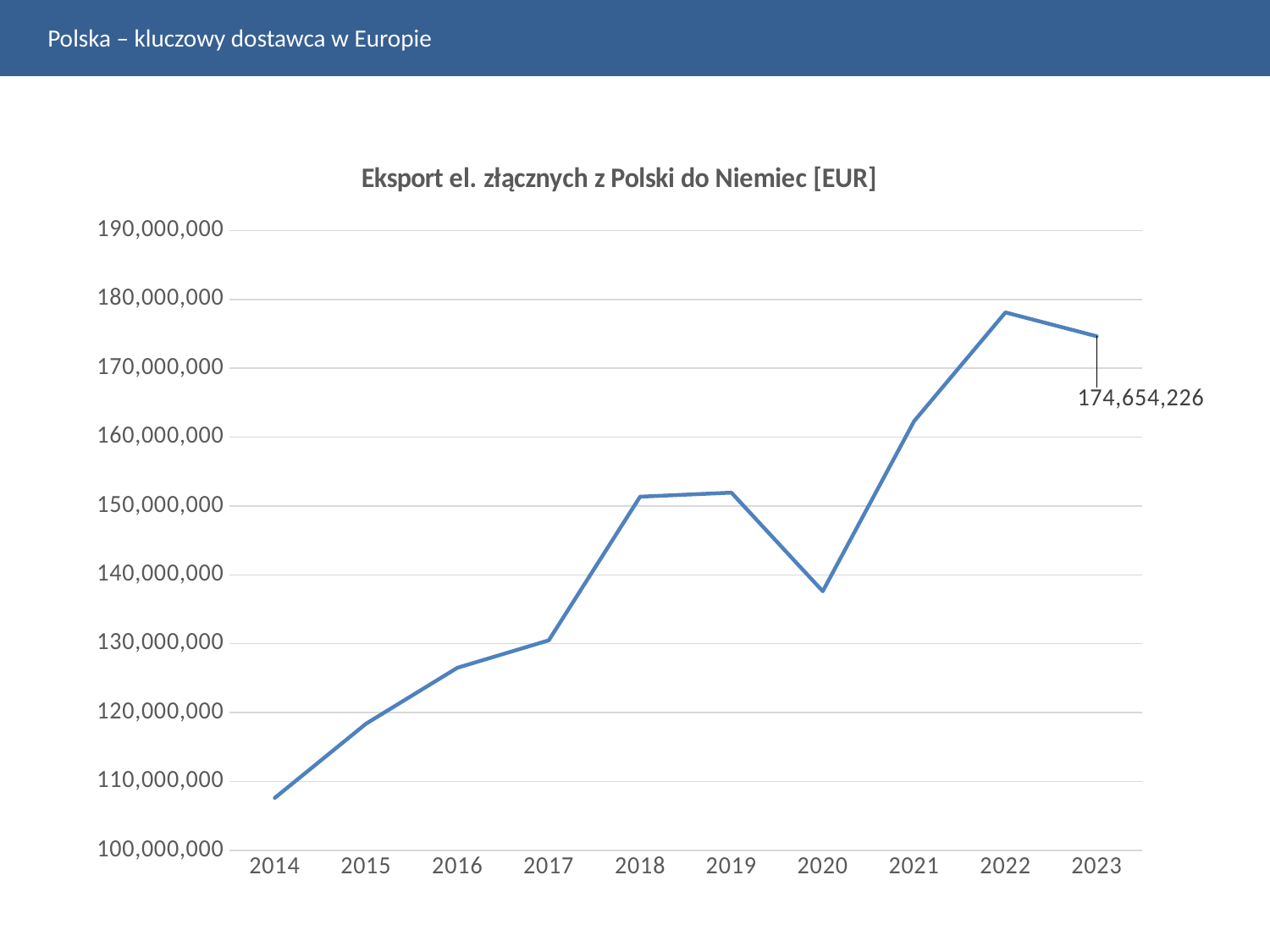
What is the title of the chart? Eksport el. złącznych z Polski do Niemiec [EUR] How many years are plotted on the x axis? 10 Is the value for 2018 greater or less than 150,000,000? greater What kind of chart is shown on the slide? line chart Which is larger, the value for 2016 or the value for 2017? 2017 What is the value for 2023? 174,654,226 Which year has the highest value? 2022 Which is larger, the value for 2019 or the value for 2020? 2019 Is the value for 2021 greater or less than 160,000,000? greater Does the value rise or fall from 2014 to 2018? rise Which year has the lowest value? 2014 Is the value for 2020 greater or less than 140,000,000? less